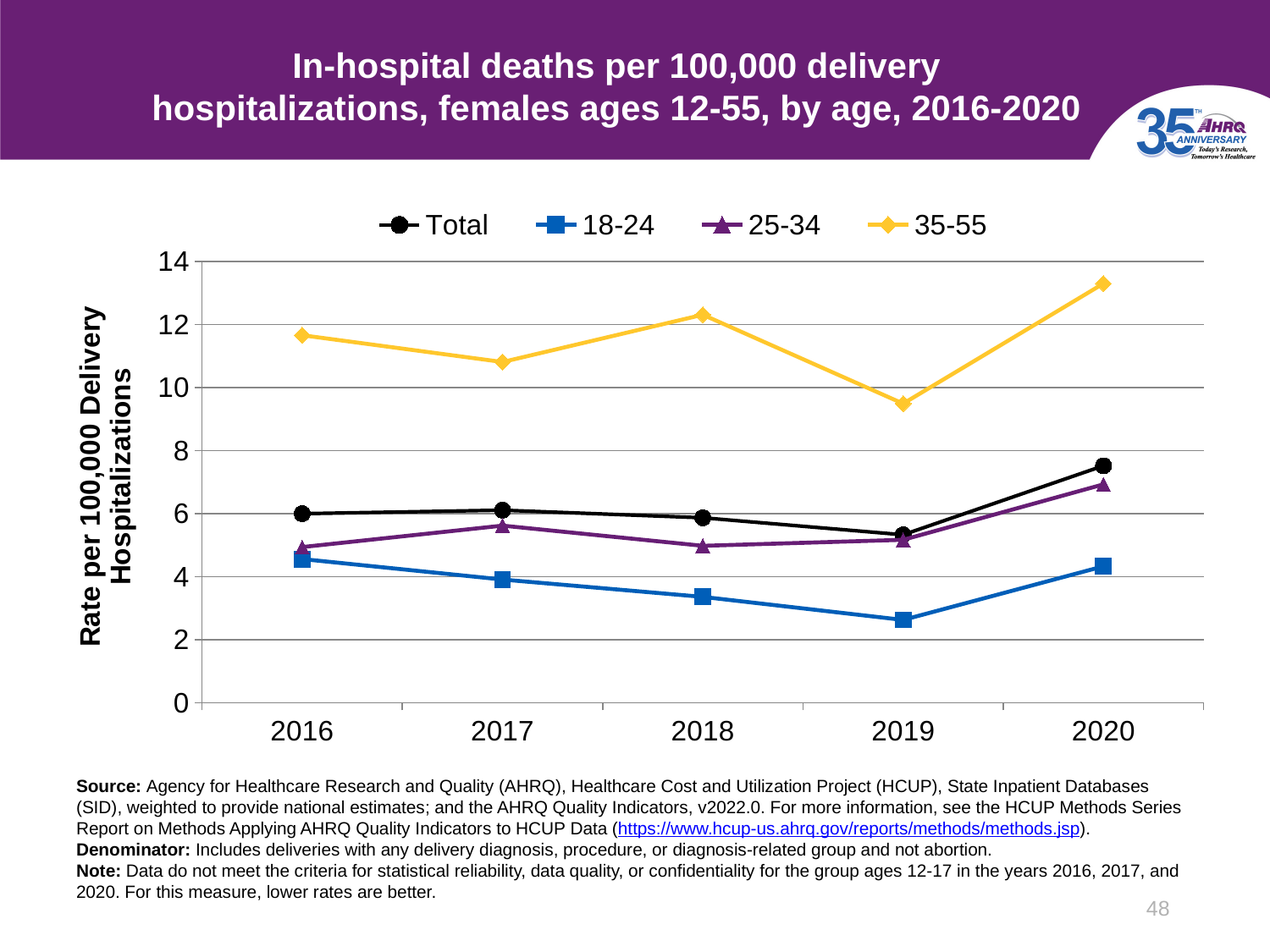
What kind of chart is shown on the slide? Line chart In 2020, which has the higher rate: ages 35-55 or ages 18-24? 35-55 How many years are plotted along the x axis? 5 Is the value for ages 35-55 in 2020 greater or less than 12? greater Is the Total value in 2020 greater or less than 6? greater In which year is the rate for ages 18-24 lowest? 2019 How many series does the legend list? 4 In which year is the rate for ages 35-55 highest? 2020 Does the rate for ages 18-24 rise or fall from 2016 to 2019? Fall What is the title of the y axis? Rate per 100,000 Delivery Hospitalizations Is the value for ages 18-24 in 2019 greater or less than 4? less In which year is the rate for ages 35-55 lowest? 2019